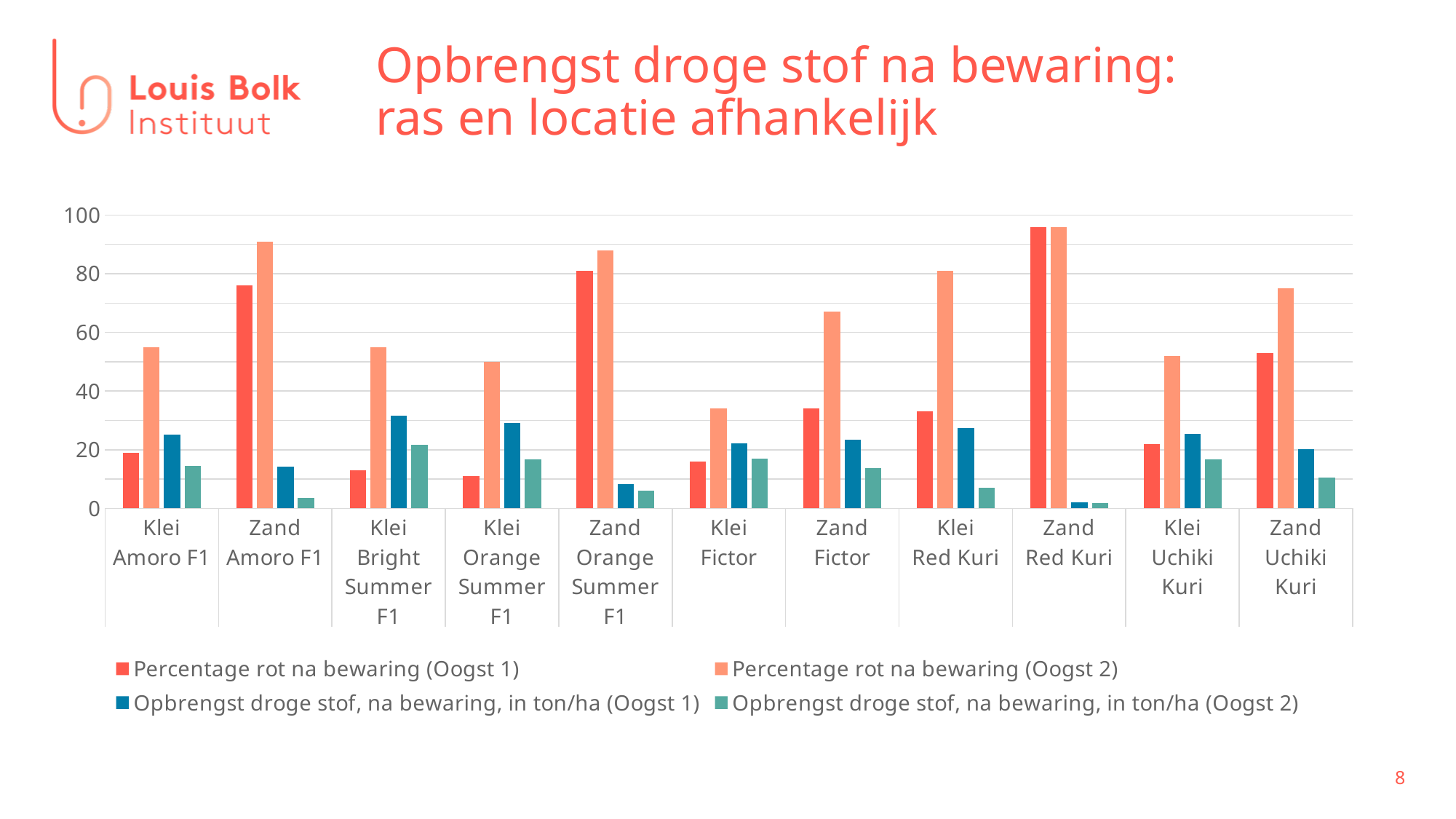
Is the value for 'Percentage rot na bewaring (Oogst 2)' at Klei Fictor greater or less than 40? less How many series does the legend list? 4 How many categories are shown on the x axis? 11 For 'Percentage rot na bewaring (Oogst 1)', which is larger: Klei Amoro F1 or Zand Amoro F1? Zand Amoro F1 Is the value for 'Opbrengst droge stof, na bewaring, in ton/ha (Oogst 1)' at Zand Orange Summer F1 greater or less than 20? less Which category has the lowest value for 'Opbrengst droge stof, na bewaring, in ton/ha (Oogst 2)'? Zand Red Kuri Which category has the highest value for 'Opbrengst droge stof, na bewaring, in ton/ha (Oogst 1)'? Klei Bright Summer F1 Which category has the lowest value for 'Percentage rot na bewaring (Oogst 2)'? Klei Fictor Which category has the highest value for 'Percentage rot na bewaring (Oogst 1)'? Zand Red Kuri Is the value for 'Percentage rot na bewaring (Oogst 1)' at Zand Amoro F1 greater or less than 60? greater What kind of chart is shown on the slide? bar chart What is the title of the chart slide? Opbrengst droge stof na bewaring: ras en locatie afhankelijk